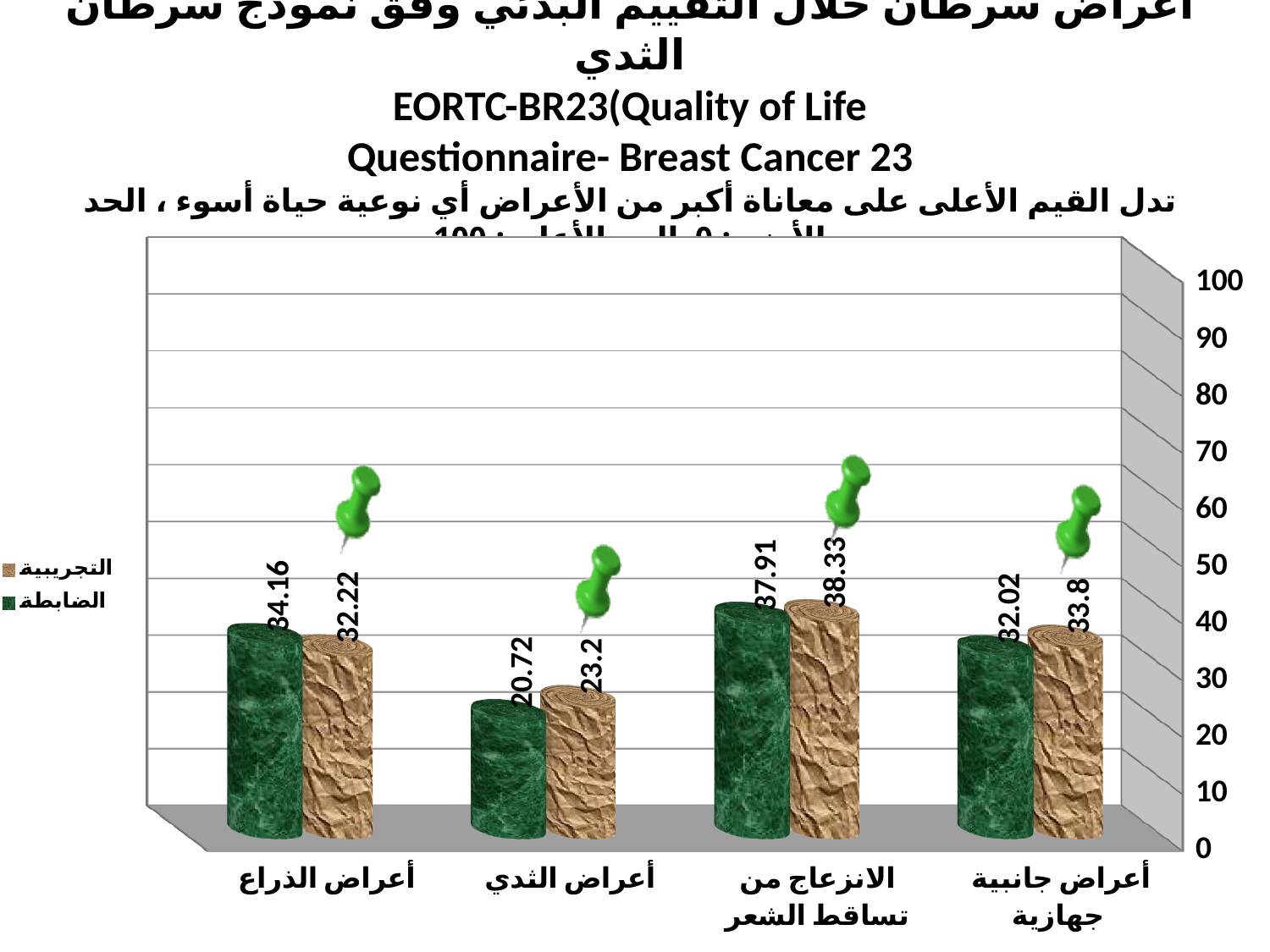
What is the difference between الضابطة and التجريبية for أعراض الثدي? 2.48 Which series is shown with green bars in the chart? الضابطة What type of chart is shown on the slide? bar chart What is the value of الضابطة for أعراض جانبية جهازية? 32.02 Which category has the highest value for التجريبية? الانزعاج من تساقط الشعر For أعراض الذراع, which series has the larger value, الضابطة or التجريبية? الضابطة Which category has the lowest value for الضابطة? أعراض الثدي What is the value of التجريبية for الانزعاج من تساقط الشعر? 38.33 How many categories are shown on the x axis of the chart? 4 How many series does the chart legend list? 2 What is the value of الضابطة for أعراض الذراع? 34.16 What is the value of التجريبية for أعراض الثدي? 23.2